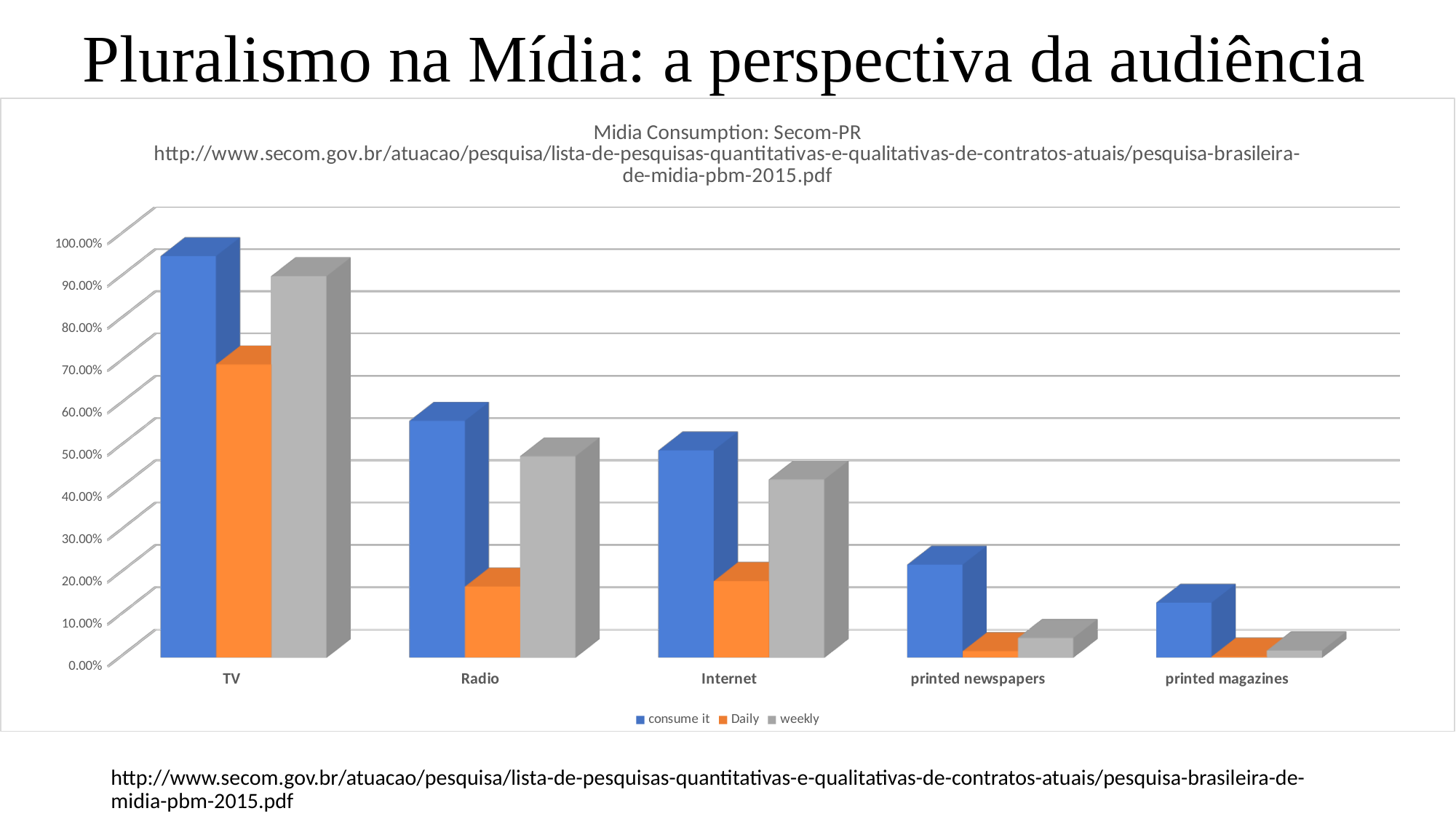
Which category has the highest value for the 'consume it' series? TV Is the 'Daily' value for Internet greater or less than 30.00%? less Do the 'consume it' values rise or fall moving from TV to printed magazines along the x axis? fall Is the 'consume it' value for TV greater or less than 80.00%? greater Is the 'consume it' value for printed magazines greater or less than 20.00%? less Which category has the lowest value for the 'consume it' series? printed magazines How many series does the chart's legend list? 3 How many categories are shown on the x axis of the chart? 5 What kind of chart is shown on the slide? bar chart Which series is shown in orange in the chart's legend? Daily For TV, which is larger: the 'Daily' value or the 'weekly' value? weekly